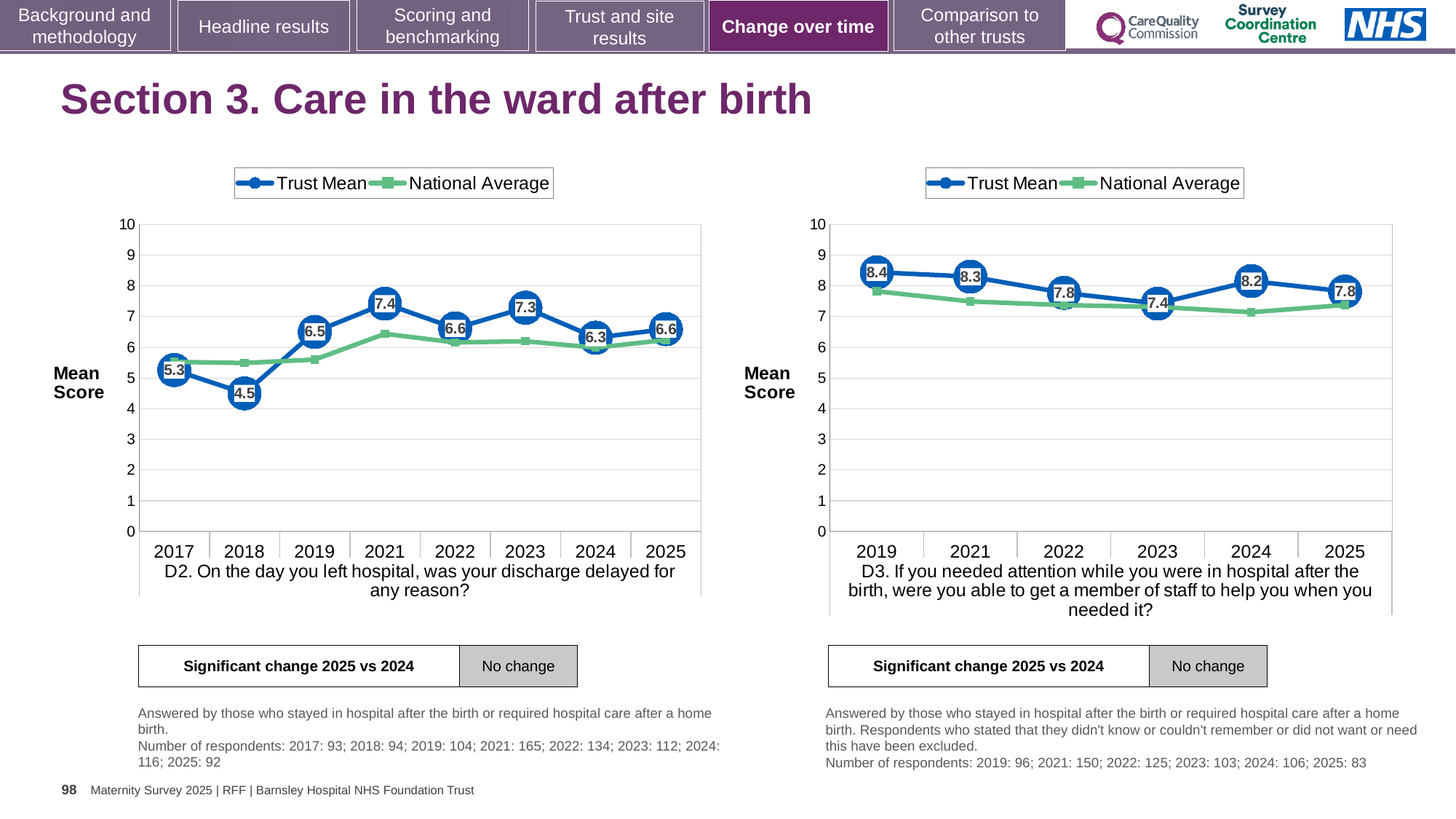
In the D2 chart (left), how many years are plotted on the x axis? 8 In the D3 chart (right), is the Trust Mean score for 2024 greater or less than the score for 2023? greater In the D3 chart (right), what is the Trust Mean score for 2019? 8.4 What type of chart is the D2 chart (left)? Line chart In the D2 chart (left), what is the difference between the Trust Mean scores for 2021 and 2018? 2.9 In the D2 chart (left), what is the Trust Mean score for 2021? 7.4 In the D2 chart (left), which year has the lowest Trust Mean score? 2018 In the D2 chart (left), which year has the highest Trust Mean score? 2021 In the D2 chart (left), what is the Trust Mean score for 2018? 4.5 How many series does the legend of the D3 chart (right) list? 2 In the D3 chart (right), is the National Average value for 2024 greater or less than 8? less In the D3 chart (right), which year has the lowest Trust Mean score? 2023